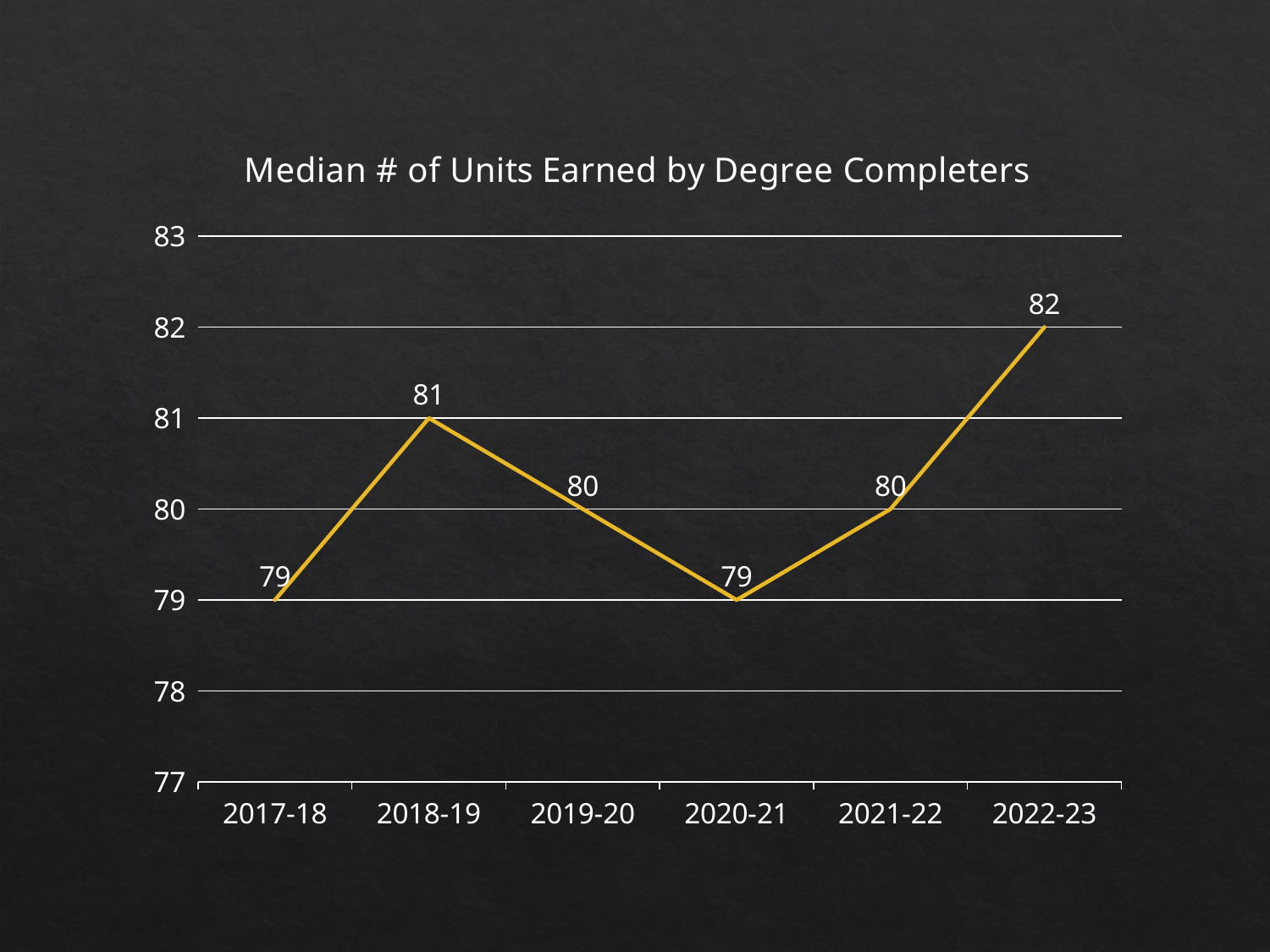
What is the median number of units earned by degree completers in 2017-18? 79 How many academic years are plotted on the chart? 6 Which is larger, the median units in 2018-19 or in 2021-22? 2018-19 What is the difference between the median units in 2022-23 and 2017-18? 3 What kind of chart is shown on the slide? Line chart What is the median number of units earned by degree completers in 2022-23? 82 What is the difference between the median units in 2018-19 and 2019-20? 1 What is the median number of units earned by degree completers in 2020-21? 79 Does the median number of units rise or fall from 2020-21 to 2022-23? Rise Which year has the highest median number of units earned? 2022-23 What is the median number of units earned by degree completers in 2018-19? 81 What is the title of the chart? Median # of Units Earned by Degree Completers